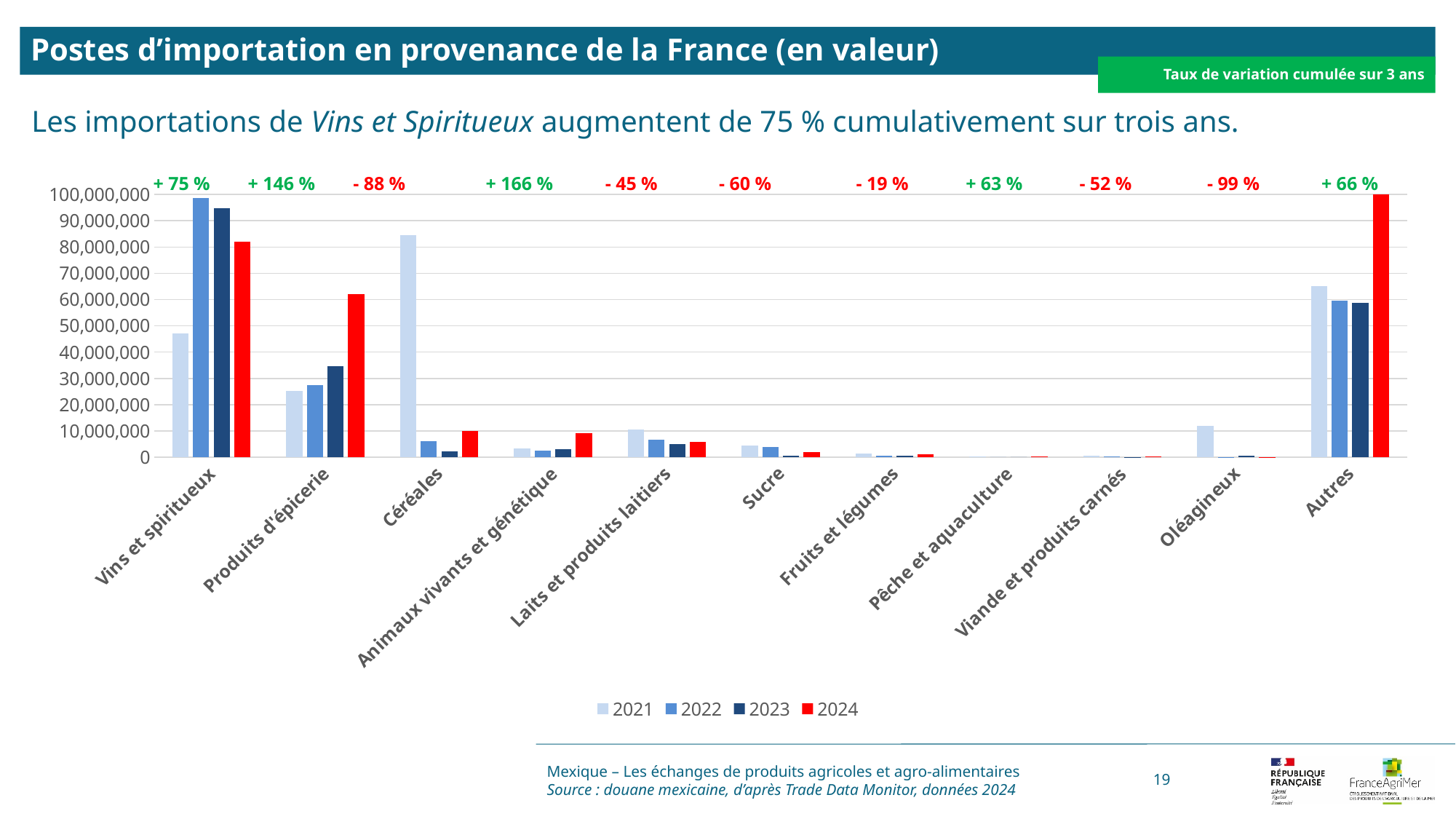
How many series does the legend list? 4 Which category has the lowest printed cumulative variation rate? Oléagineux (- 99 %) Do the bars for Produits d'épicerie rise or fall from 2021 to 2024? rise Which category has the tallest 2021 bar? Céréales Which category has the tallest 2024 bar? Autres Is the 2022 value for Vins et spiritueux greater or less than 90,000,000? greater What cumulative variation rate over 3 years is printed above Produits d'épicerie? + 146 % What kind of chart is shown on the slide? bar chart How many categories are shown on the x axis? 11 Which category has the highest printed cumulative variation rate? Animaux vivants et génétique (+ 166 %) Is the 2021 value for Oléagineux greater or less than 20,000,000? less What cumulative variation rate over 3 years is printed above Oléagineux? - 99 %